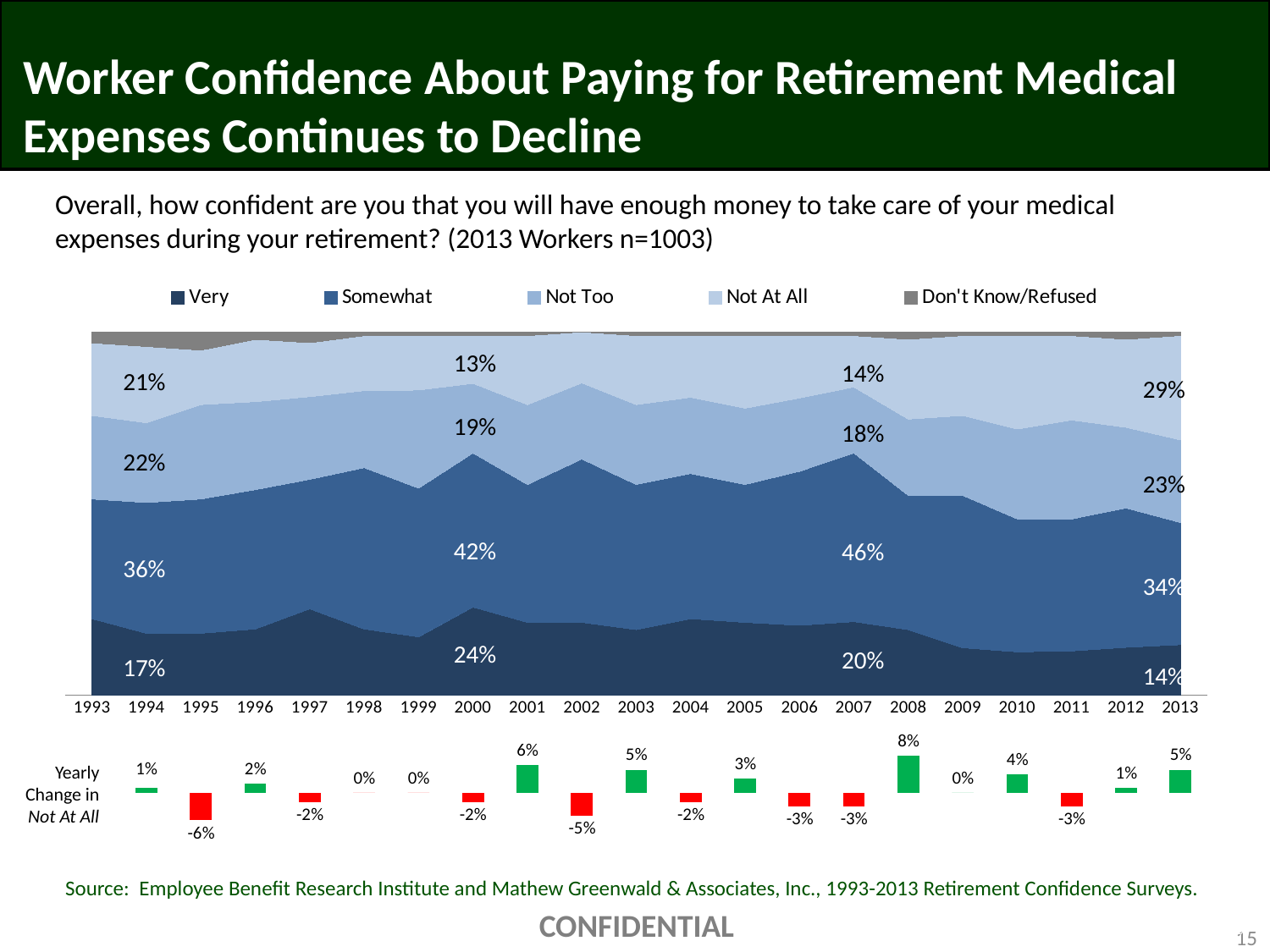
In the 'Yearly Change in Not At All' bar chart, what is the value for 2013? 5% In the stacked area chart, which is larger: the 'Very' share in 2000 or the 'Very' share in 2013? 2000 (24%) In the 'Yearly Change in Not At All' bar chart, which year has the largest decrease? 1995 (-6%) What kind of chart is the main chart showing confidence levels from 1993 to 2013? Stacked area chart How many series does the legend of the stacked area chart list? 5 How many years are shown on the x axis of the stacked area chart? 21 In the stacked area chart, what percentage of workers were 'Very' confident in 2013? 14% In the stacked area chart, what was the 'Somewhat' confident share in 2007? 46% In the 'Yearly Change in Not At All' bar chart, which year has the largest increase? 2008 (8%) In the stacked area chart, what was the 'Not Too' confident share in 2000? 19%